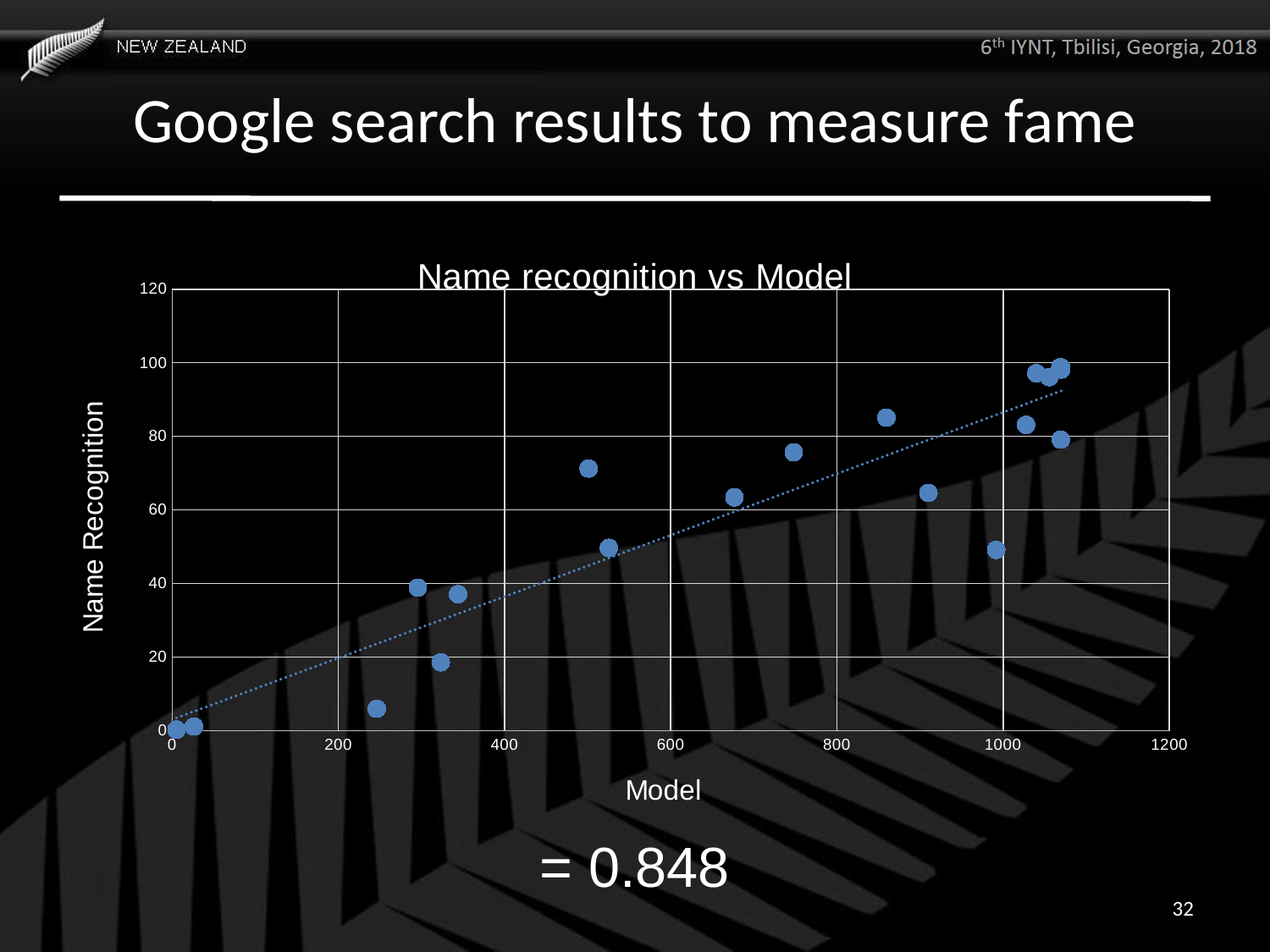
What is the highest value shown on the vertical axis? 120 What is the label of the vertical axis? Name Recognition Is the Name Recognition value for the point at Model of about 860 greater or less than 80? greater Is the Name Recognition value for the point at Model of about 990 greater or less than 60? less Is the Name Recognition value for the point at Model of about 750 greater or less than 80? less Do the Name Recognition values generally rise or fall as Model increases along the x axis? Rise Which has the larger Name Recognition value: the point at Model of about 500 or the point at Model of about 990? The point at Model of about 500 What kind of chart is shown on the slide? Scatter chart What is the title of the chart? Name recognition vs Model